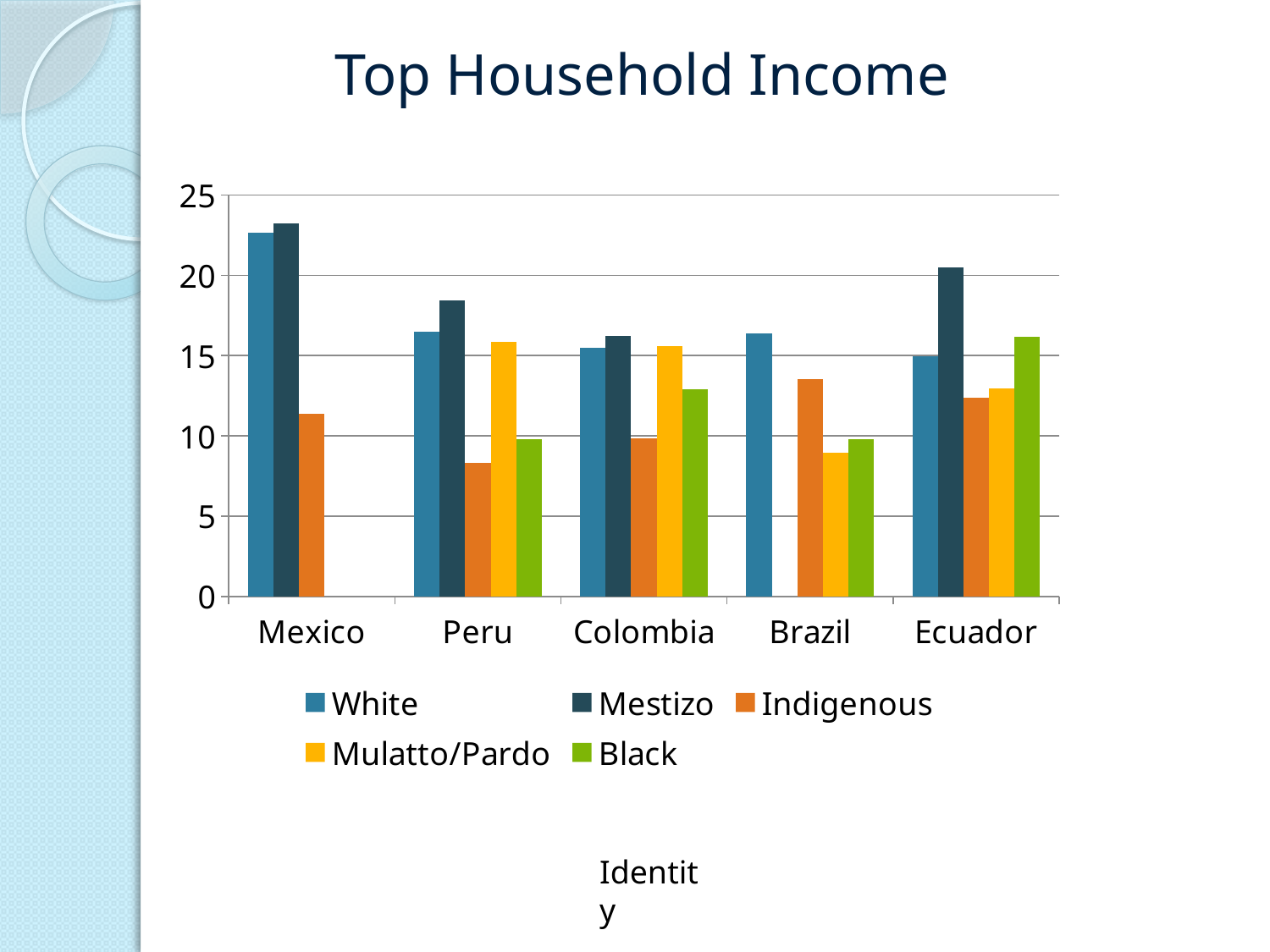
Is the value for White in Mexico greater or less than 20? greater Is the value for Black in Colombia greater or less than 15? less How many series does the legend list? 5 How many countries are shown on the x axis? 5 Which country has the lowest Indigenous bar? Peru Is the value for Indigenous in Peru greater or less than 10? less Which country has the highest Mestizo bar? Mexico What kind of chart is shown on the slide? bar chart What is the title of the chart? Top Household Income In Mexico, which is larger: the Mestizo bar or the Indigenous bar? Mestizo In Ecuador, which is larger: the Mestizo bar or the White bar? Mestizo